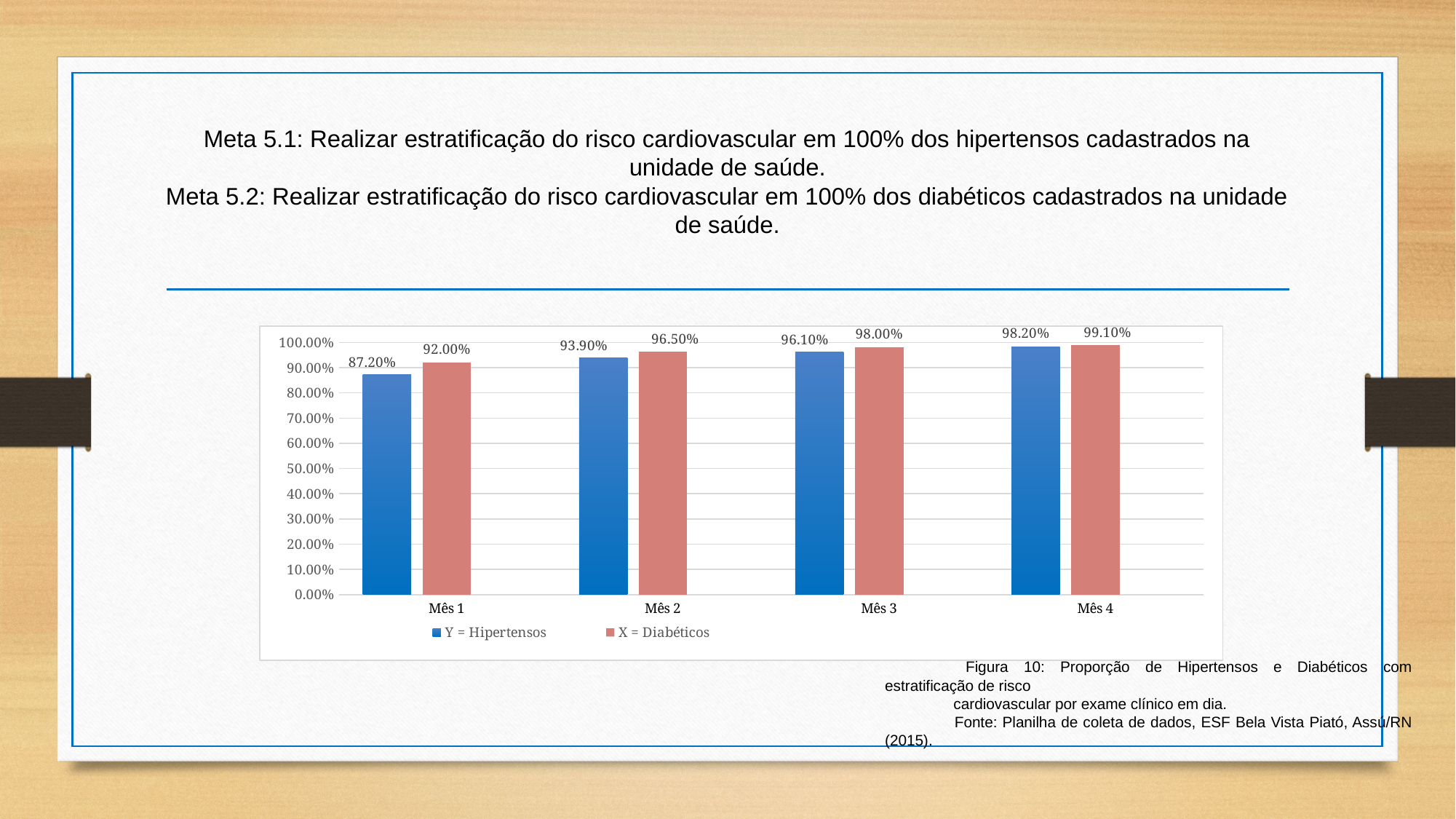
How many series does the legend list? 2 What kind of chart is shown on the slide? Bar chart What is the value for X = Diabéticos in Mês 3? 98.00% How many months are shown on the x axis? 4 Do the values for Y = Hipertensos rise or fall from Mês 1 to Mês 4? Rise In which month is the value for Y = Hipertensos lowest? Mês 1 What is the value for X = Diabéticos in Mês 2? 96.50% What is the value for Y = Hipertensos in Mês 4? 98.20% What is the difference between X = Diabéticos and Y = Hipertensos in Mês 1? 4.80% In which month is the value for X = Diabéticos highest? Mês 4 What is the value for Y = Hipertensos in Mês 1? 87.20% Which is larger in Mês 2: Y = Hipertensos or X = Diabéticos? X = Diabéticos